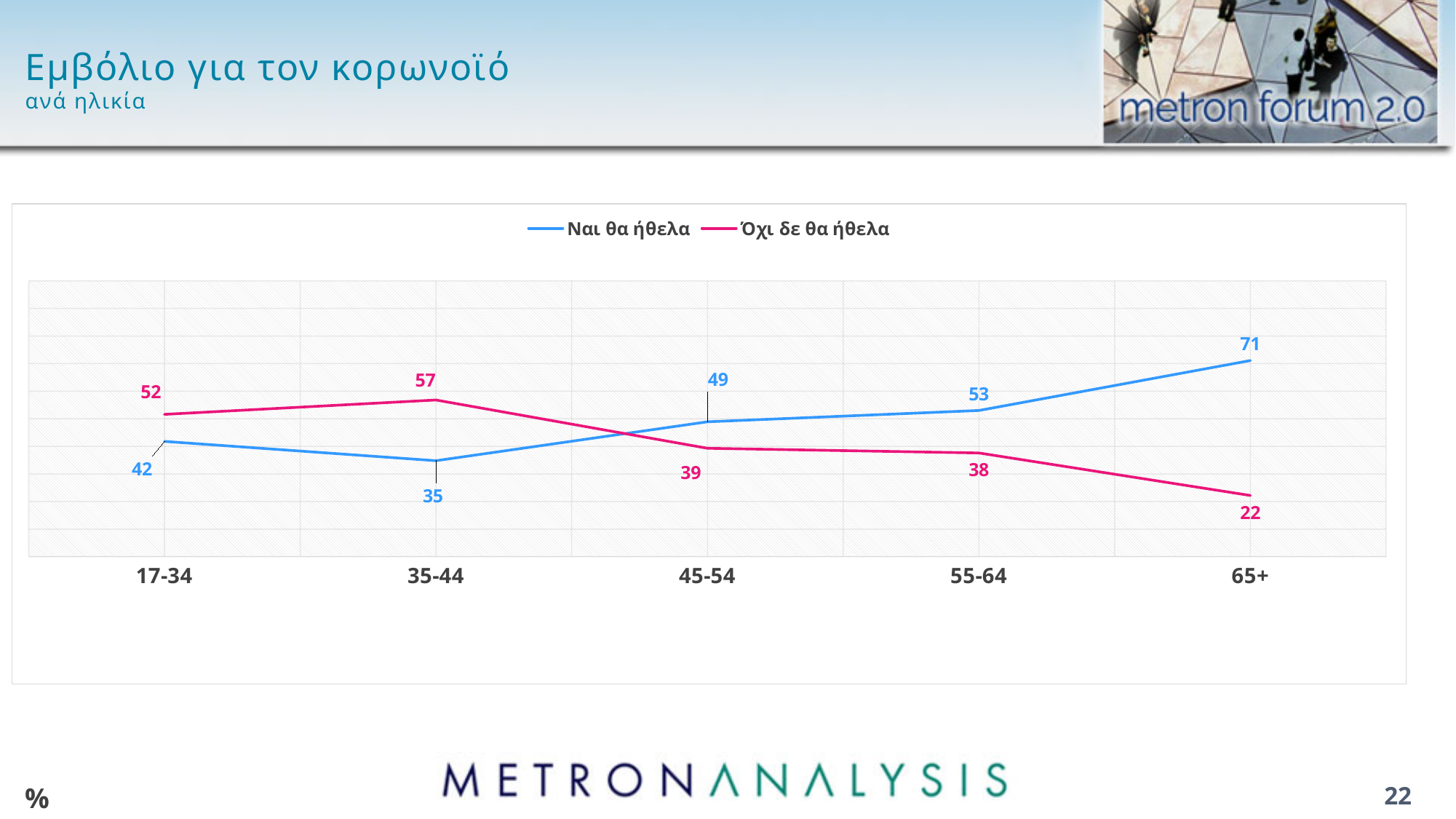
What is the difference between 'Ναι θα ήθελα' and 'Όχι δε θα ήθελα' in the 65+ age group? 49 Which age group has the lowest value for 'Όχι δε θα ήθελα'? 65+ What is the value for 'Όχι δε θα ήθελα' in the 35-44 age group? 57 What is the value for 'Ναι θα ήθελα' in the 65+ age group? 71 What is the value for 'Ναι θα ήθελα' in the 17-34 age group? 42 In the 35-44 age group, which series has the larger value, 'Ναι θα ήθελα' or 'Όχι δε θα ήθελα'? Όχι δε θα ήθελα How many age groups are shown on the x axis? 5 What kind of chart is shown on the slide? Line chart Which age group has the highest value for 'Ναι θα ήθελα'? 65+ Does the 'Όχι δε θα ήθελα' series rise or fall from the 35-44 group to the 65+ group? Fall Which age group has the lowest value for 'Ναι θα ήθελα'? 35-44 How many series does the legend list? 2